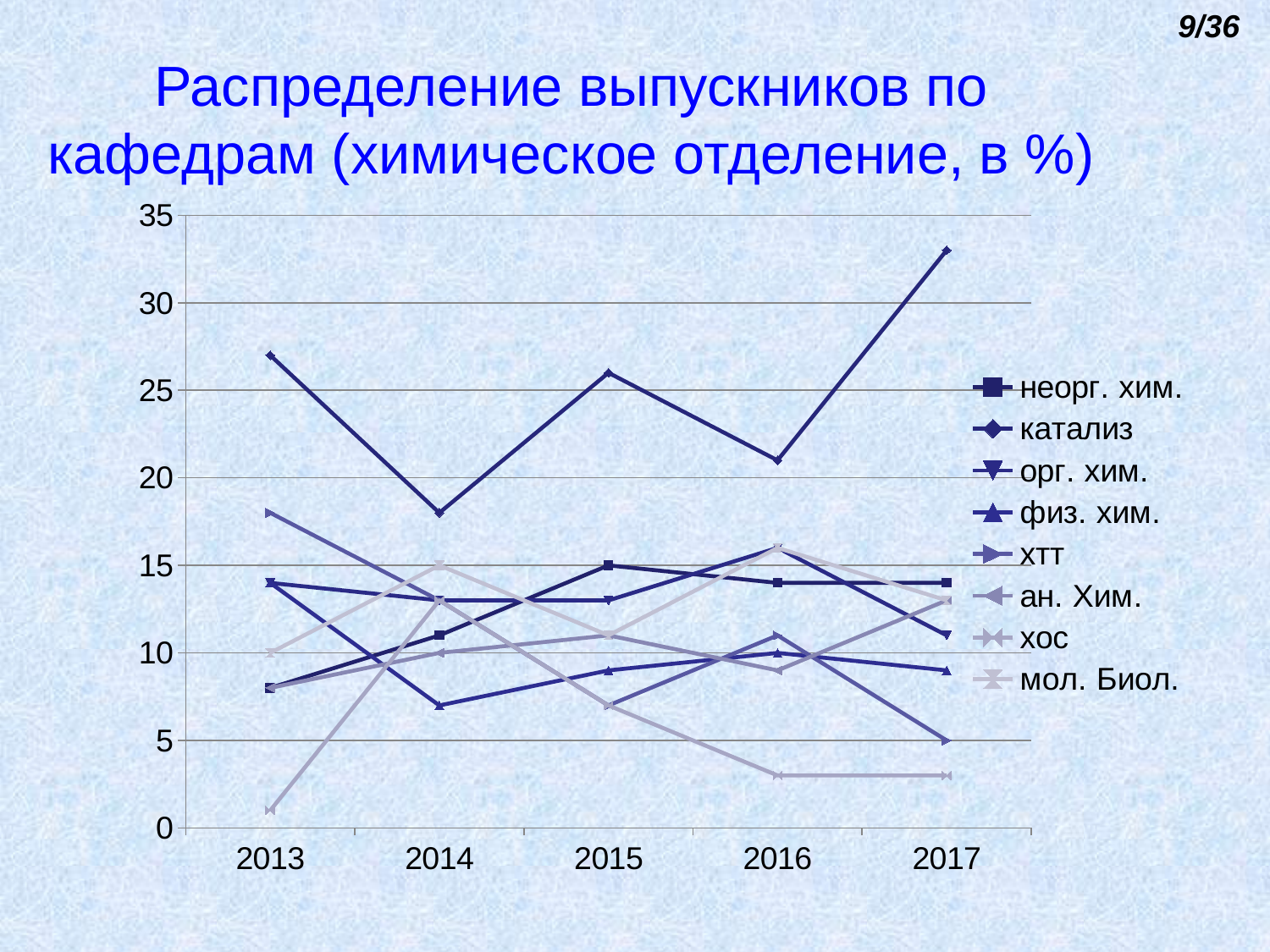
Is the value for хос in 2013 greater or less than 5? less How many years are shown on the x axis? 5 What is the title of the chart? Распределение выпускников по кафедрам (химическое отделение, в %) Which series has the lowest value in 2013? хос What kind of chart is shown on the slide? line chart Does the катализ series rise or fall from 2016 to 2017? rise Is the value for катализ in 2014 greater or less than 20? less Is the value for катализ in 2013 greater or less than 25? greater In which year does the катализ series reach its highest value? 2017 Which series has the highest value in 2017? катализ How many series does the legend list? 8